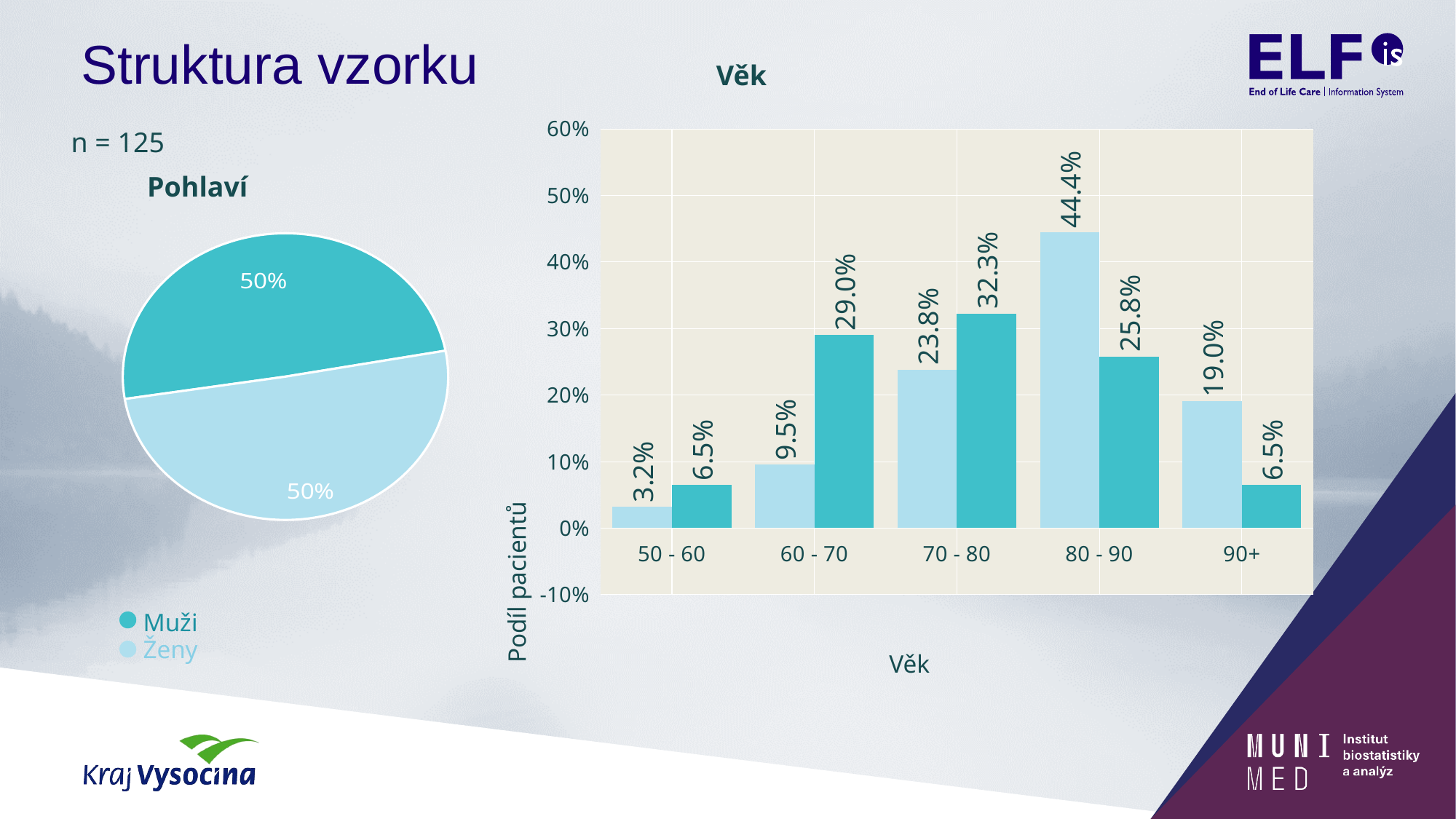
In the 'Věk' bar chart, which age group has the highest dark teal bar? 70 - 80 In the 'Pohlaví' pie chart, what share does Muži have? 50% How many entries does the legend on the slide list? 2 In the 'Věk' bar chart, what is the difference between the light blue and dark teal bars for the 80 - 90 age group? 18.6% What kind of chart is the 'Pohlaví' chart? pie chart How many age groups are shown on the x axis of the 'Věk' bar chart? 5 In the 'Věk' bar chart, what is the value of the light blue bar for the 50 - 60 age group? 3.2% In the 'Věk' bar chart, which is larger for the 70 - 80 age group: the light blue bar or the dark teal bar? the dark teal bar In the 'Věk' bar chart, what is the value of the light blue bar for the 80 - 90 age group? 44.4% In the 'Věk' bar chart, which age group has the highest light blue bar? 80 - 90 In the 'Věk' bar chart, what is the value of the dark teal bar for the 60 - 70 age group? 29.0% In the 'Věk' bar chart, which age group has the lowest light blue bar? 50 - 60